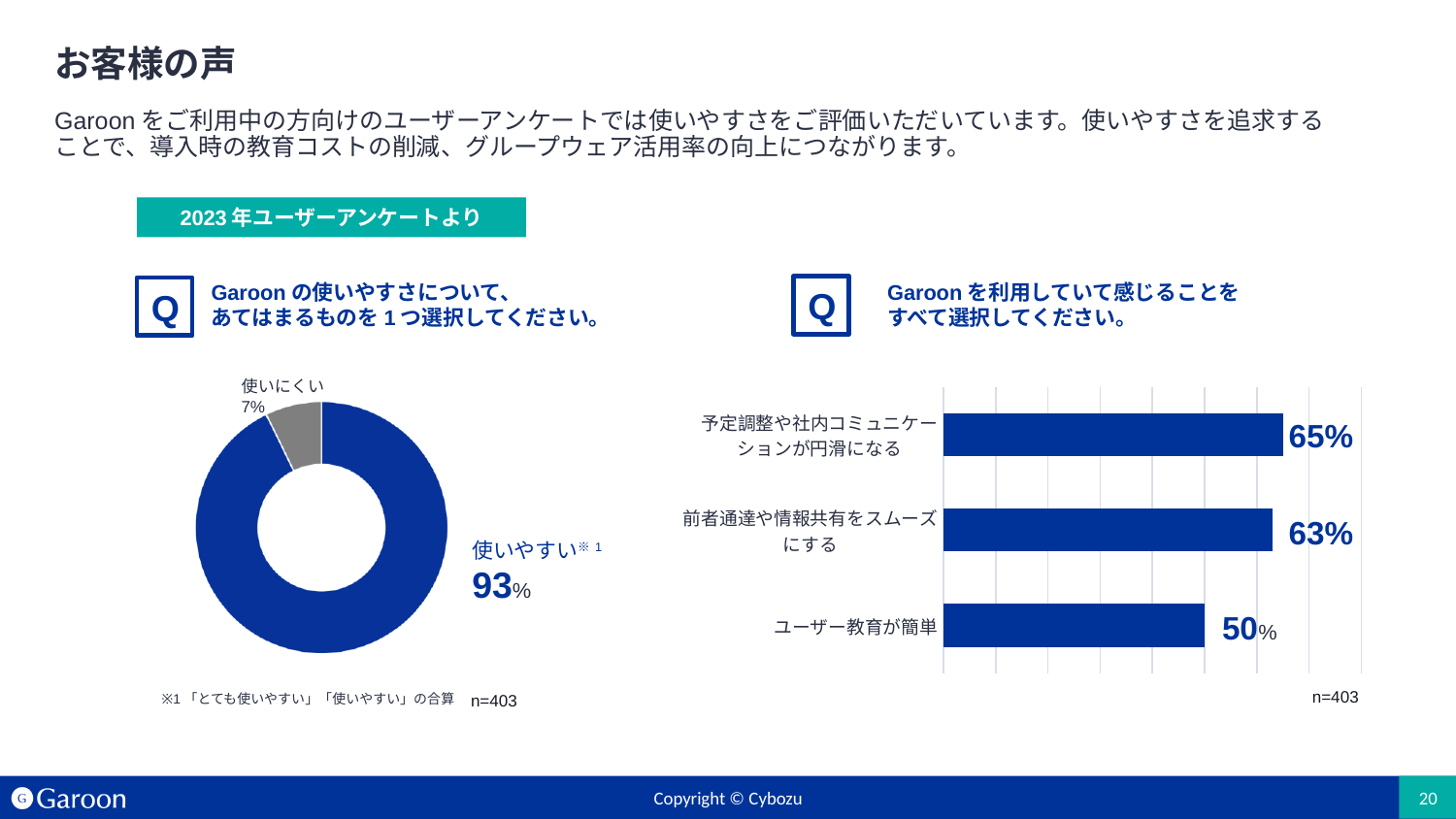
In the donut chart on the left, what percentage of respondents answered 使いにくい? 7% In the donut chart on the left, which slice is larger, 使いやすい or 使いにくい? 使いやすい In the bar chart on the right, what is the difference between 前者通達や情報共有をスムーズにする and ユーザー教育が簡単? 13 percentage points In the bar chart on the right, which category has the highest value? 予定調整や社内コミュニケーションが円滑になる In the donut chart on the left, how many slices are there? 2 In the bar chart on the right, what is the value for 予定調整や社内コミュニケーションが円滑になる? 65% In the bar chart on the right, what is the value for ユーザー教育が簡単? 50% In the donut chart on the left, what is the difference in percentage points between 使いやすい and 使いにくい? 86 In the bar chart on the right, which category has the lowest value? ユーザー教育が簡単 In the donut chart on the left, what percentage of respondents answered 使いやすい? 93% What kind of chart is shown on the right side of the slide? Bar chart What kind of chart is shown on the left side of the slide? Donut (pie) chart